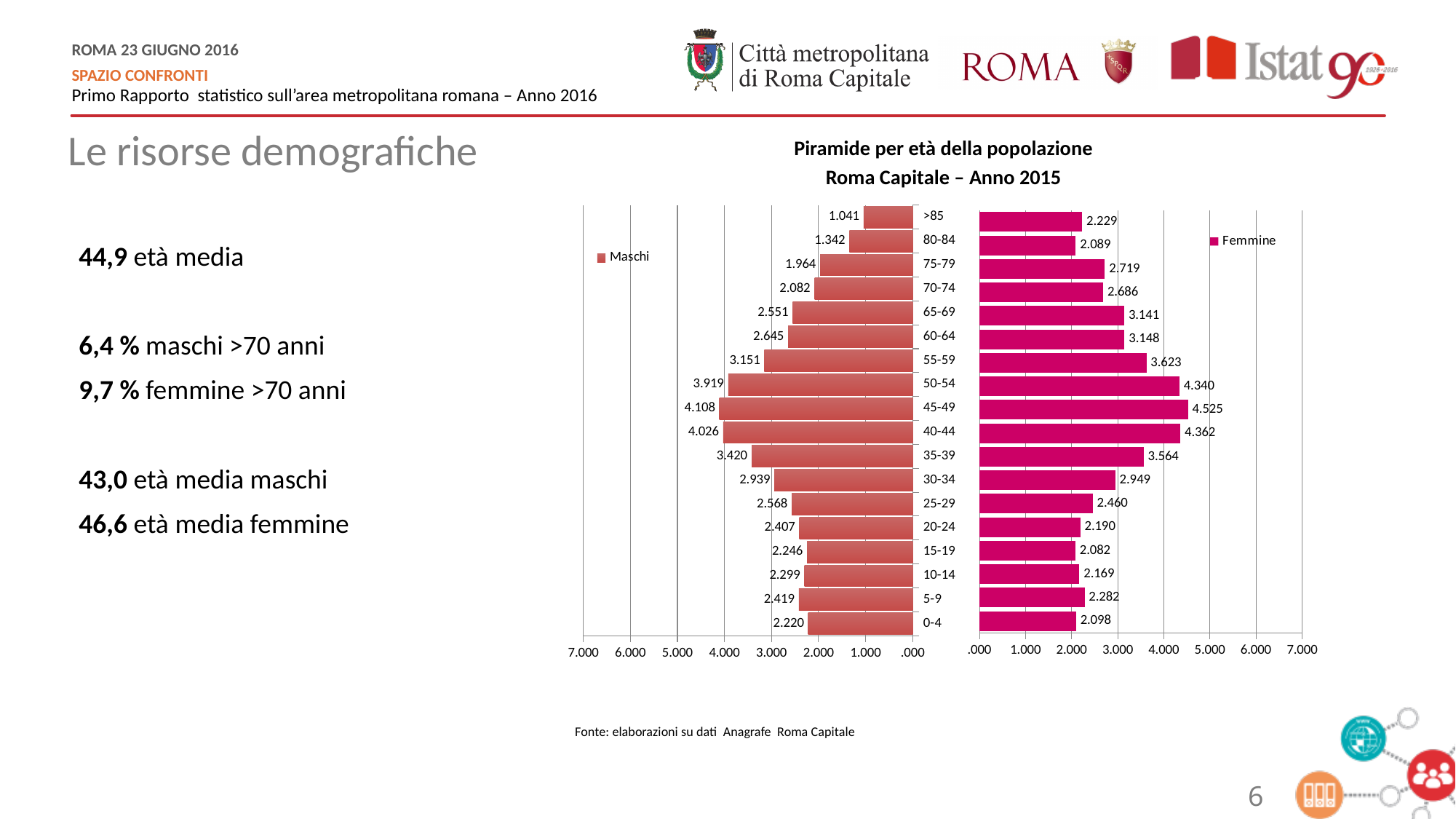
Which age group has the lowest value for Maschi? >85 Is the value for Maschi in the 55-59 age group greater or less than 3.000? greater How many series does the chart show? 2 What is the value for Maschi in the 0-4 age group? 2.220 What is the value for Maschi in the 45-49 age group? 4.108 Which is larger in the >85 age group, Maschi or Femmine? Femmine Which age group has the highest value for Femmine? 45-49 What kind of chart is shown on the slide? bar chart How many age groups are shown in the chart? 18 What is the difference between the Femmine and Maschi values in the 45-49 age group? 417 What is the combined total of Maschi and Femmine in the 0-4 age group? 4.318 What is the value for Femmine in the >85 age group? 2.229